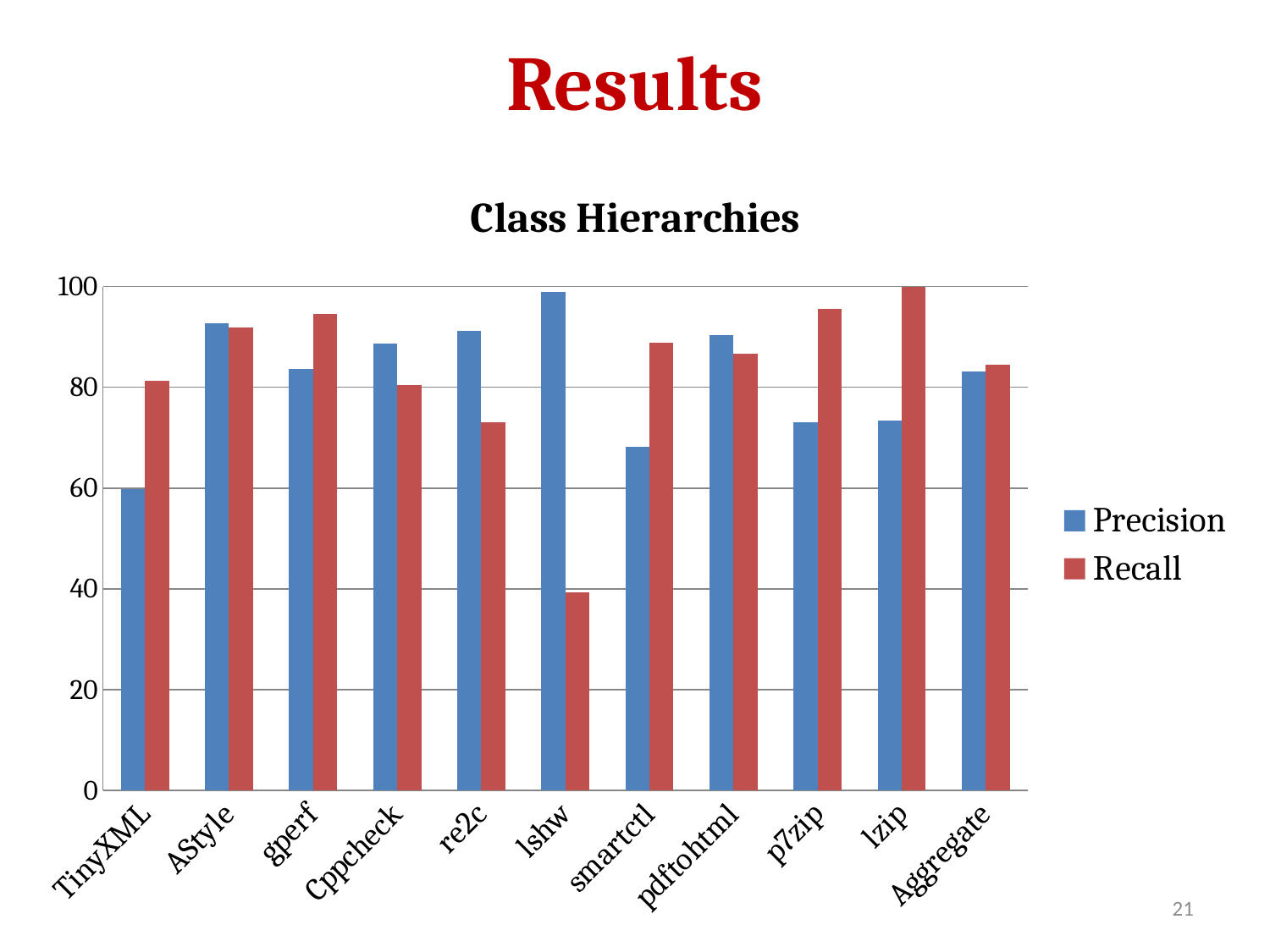
Which category has the highest Recall value? lzip Is the Recall value for lshw greater or less than 60? less How many series does the legend list? 2 Which category has the lowest Recall value? lshw How many categories are shown on the x axis? 11 For smartctl, which is larger, Precision or Recall? Recall Which category has the highest Precision value? lshw For re2c, which is larger, Precision or Recall? Precision What is the title of the chart? Class Hierarchies What kind of chart is shown on the slide? bar chart Which category has the lowest Precision value? TinyXML Is the Precision value for TinyXML greater or less than 80? less